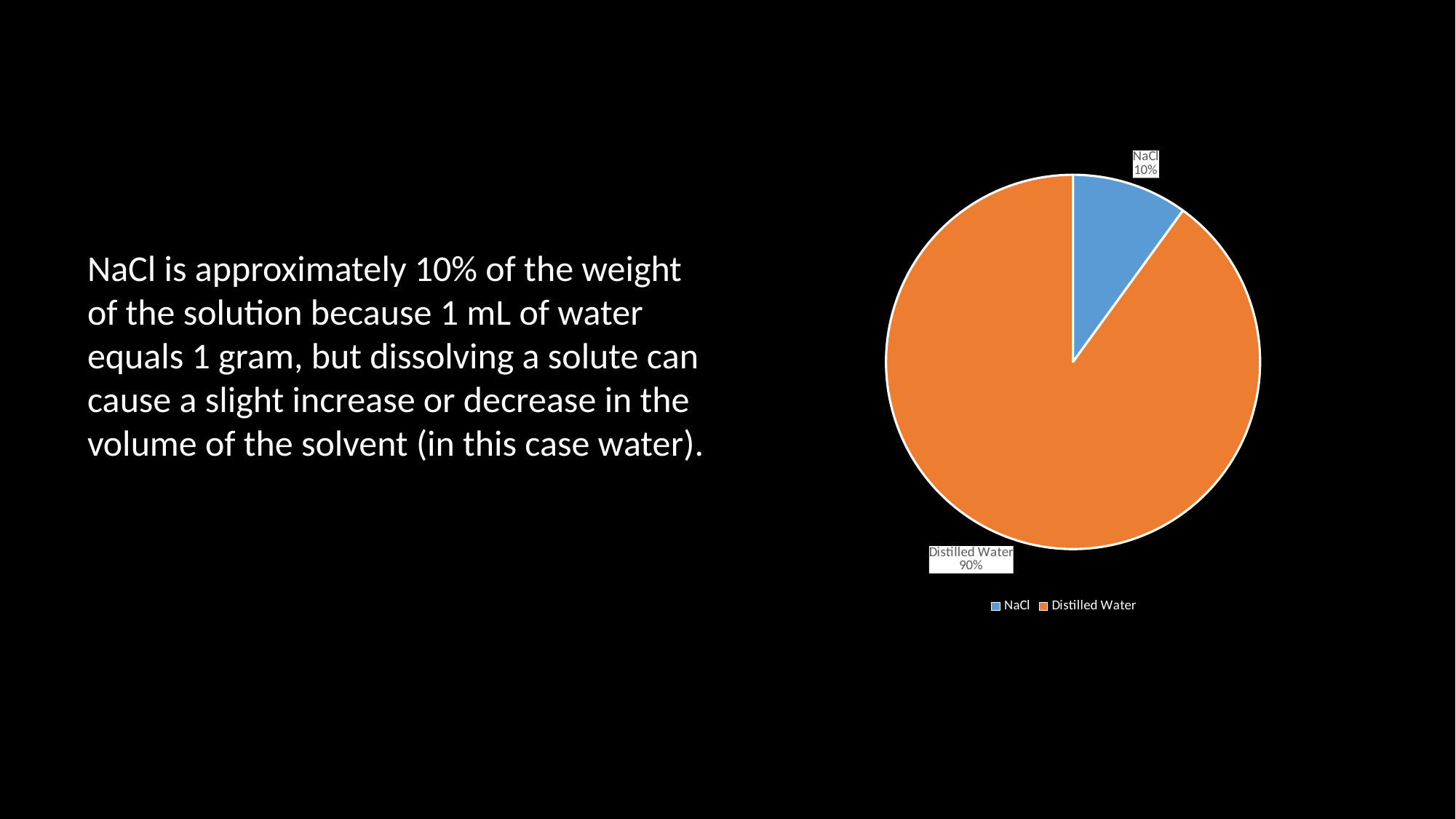
What share of the pie does Distilled Water represent? 90% Which is larger, the NaCl slice or the Distilled Water slice? Distilled Water Which slice of the pie is the smallest? NaCl How many slices does the pie chart have? 2 What is the difference in percentage points between the Distilled Water slice and the NaCl slice? 80 What kind of chart is shown on the slide? pie chart How many entries does the legend list? 2 What colour is the Distilled Water slice? orange Which slice of the pie is the largest? Distilled Water What colour is the NaCl slice? blue What share of the pie does NaCl represent? 10%